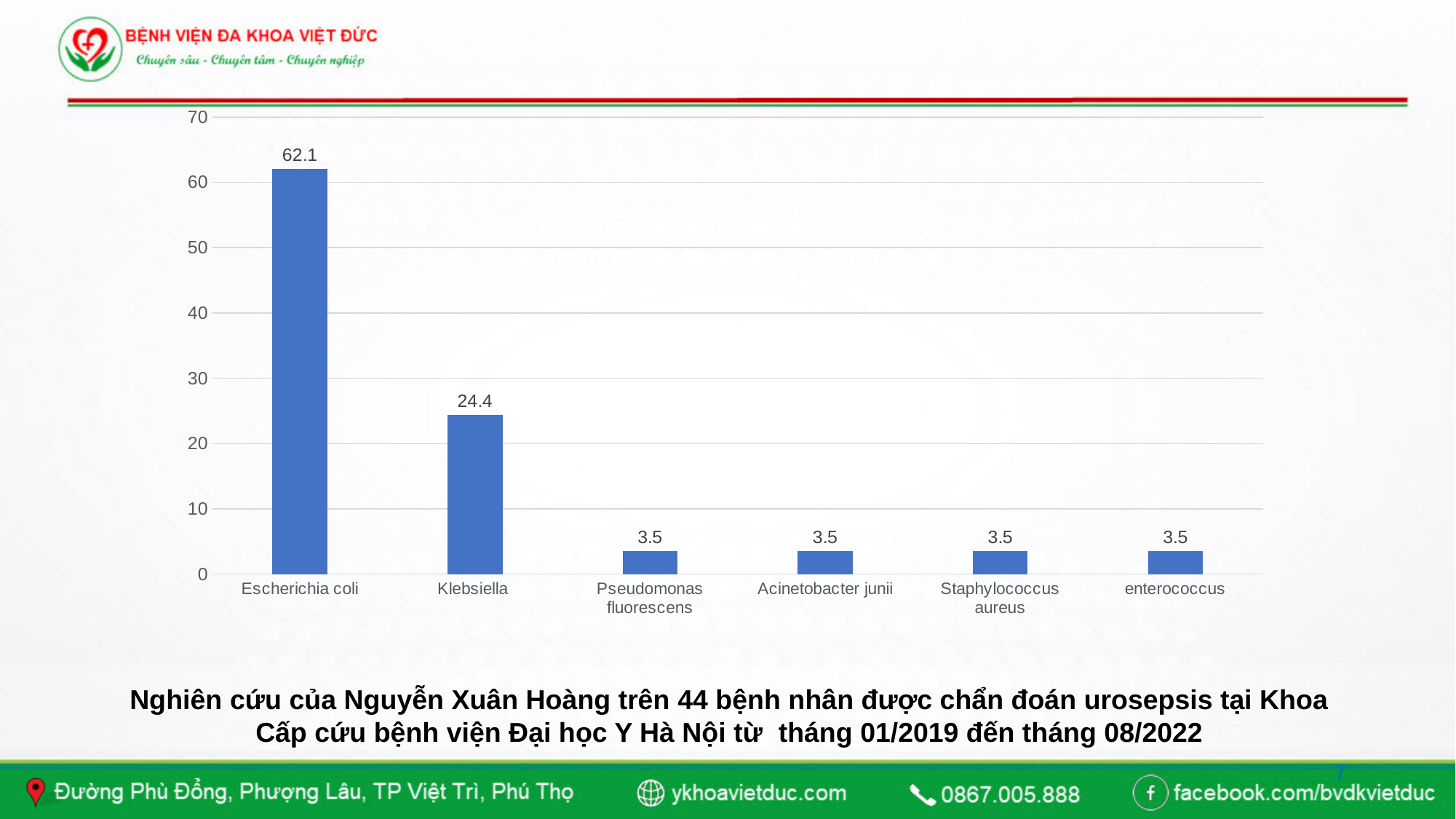
Is the value for Escherichia coli greater or less than 60? greater What is the value for Staphylococcus aureus? 3.5 What is the difference between the values for Escherichia coli and Klebsiella? 37.7 How many categories are shown on the x axis? 6 What is the value for Klebsiella? 24.4 What is the difference between the values for Klebsiella and Acinetobacter junii? 20.9 Which category has the highest value? Escherichia coli What is the value for Pseudomonas fluorescens? 3.5 What kind of chart is shown on the slide? bar chart Which is larger, the value for Klebsiella or the value for enterococcus? Klebsiella How many categories share the value 3.5? 4 What is the value for Escherichia coli? 62.1